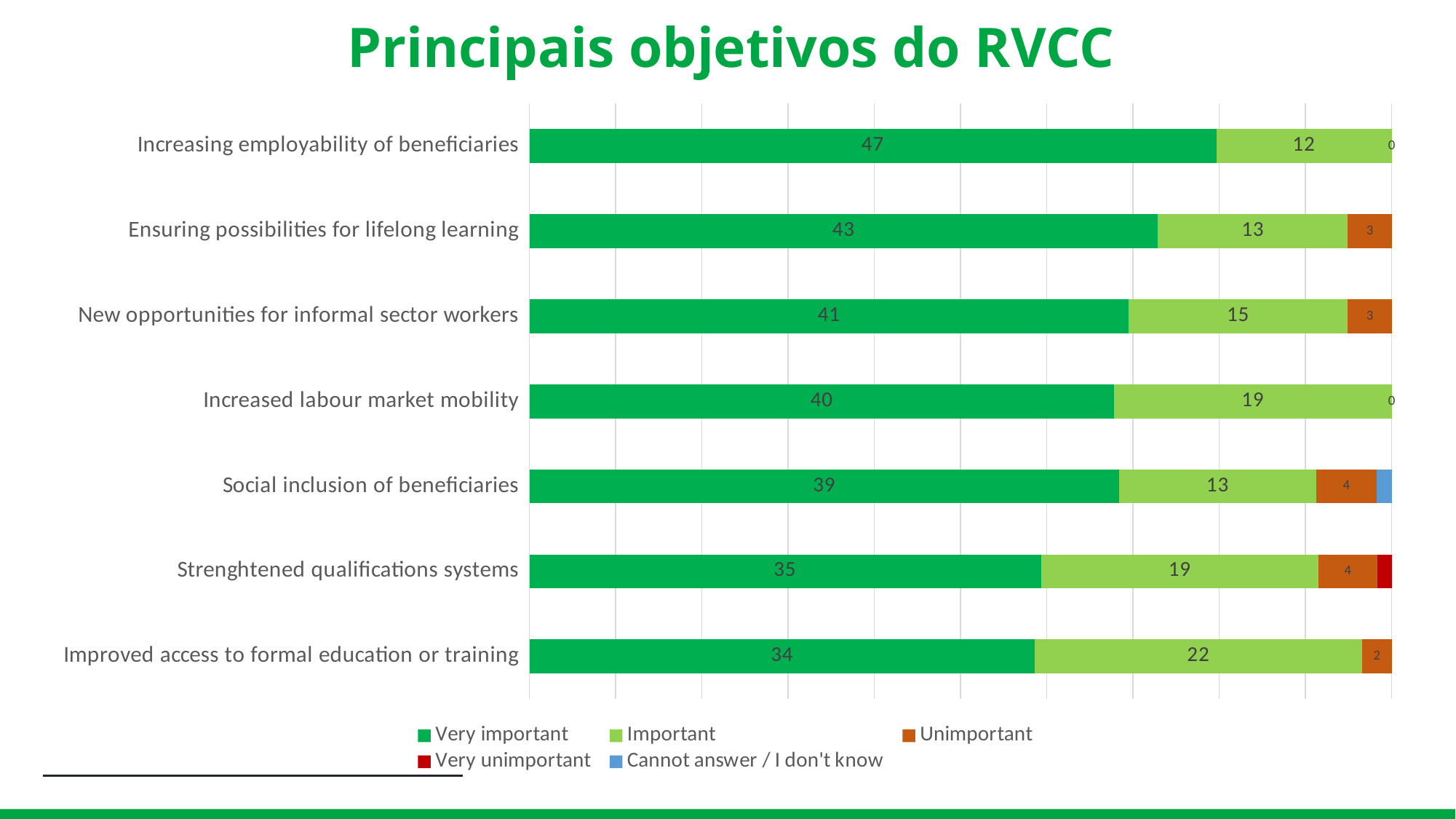
What is the 'Very important' value for 'Increasing employability of beneficiaries'? 47 Which category has the highest 'Very important' value? Increasing employability of beneficiaries How many series does the legend list? 5 Which has the larger 'Important' value: 'Increased labour market mobility' or 'Social inclusion of beneficiaries'? Increased labour market mobility What is the 'Important' value for 'Improved access to formal education or training'? 22 What kind of chart is shown on the slide? Stacked bar chart What is the 'Important' value for 'New opportunities for informal sector workers'? 15 What is the title of the slide? Principais objetivos do RVCC What is the 'Unimportant' value for 'Social inclusion of beneficiaries'? 4 Which category has the lowest 'Very important' value? Improved access to formal education or training How many categories are shown on the chart? 7 What is the difference between the 'Very important' values for 'Increasing employability of beneficiaries' and 'Improved access to formal education or training'? 13